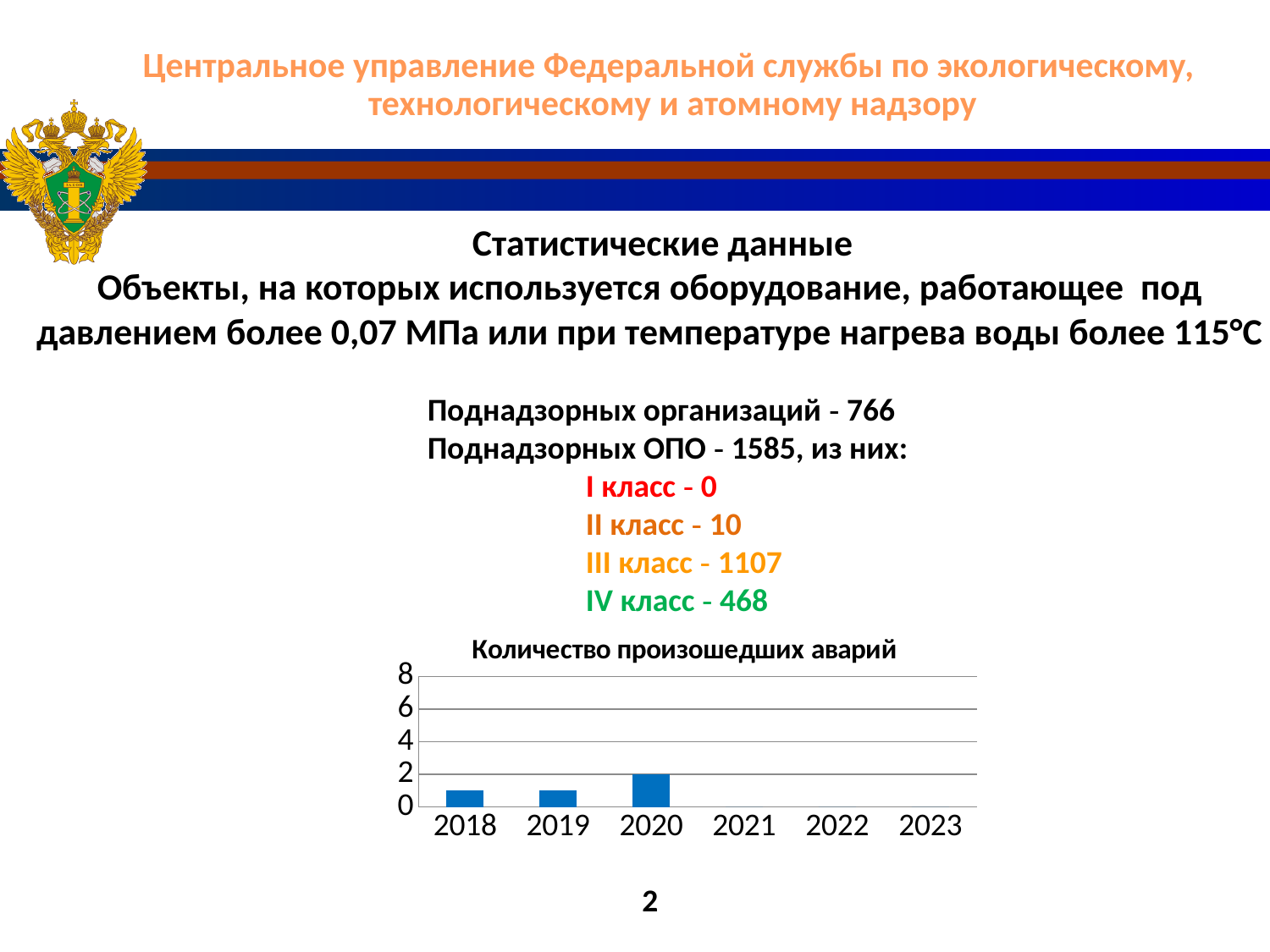
How many years are shown on the x axis of the chart? 6 Which is larger, the value for 2020 or the value for 2018? 2020 Which year has the highest number of accidents in the chart? 2020 Is the value for 2020 greater or less than 4? less What is the title of the chart on the slide? Количество произошедших аварий Is the value for 2019 greater or less than 2? less What type of chart is shown on the slide? bar chart What is the highest value shown on the y axis of the chart? 8 Is the value for 2018 greater or less than 2? less What is the first year shown on the x axis of the chart? 2018 Which is larger, the value for 2019 or the value for 2021? 2019 What is the value for 2020 in the chart? 2